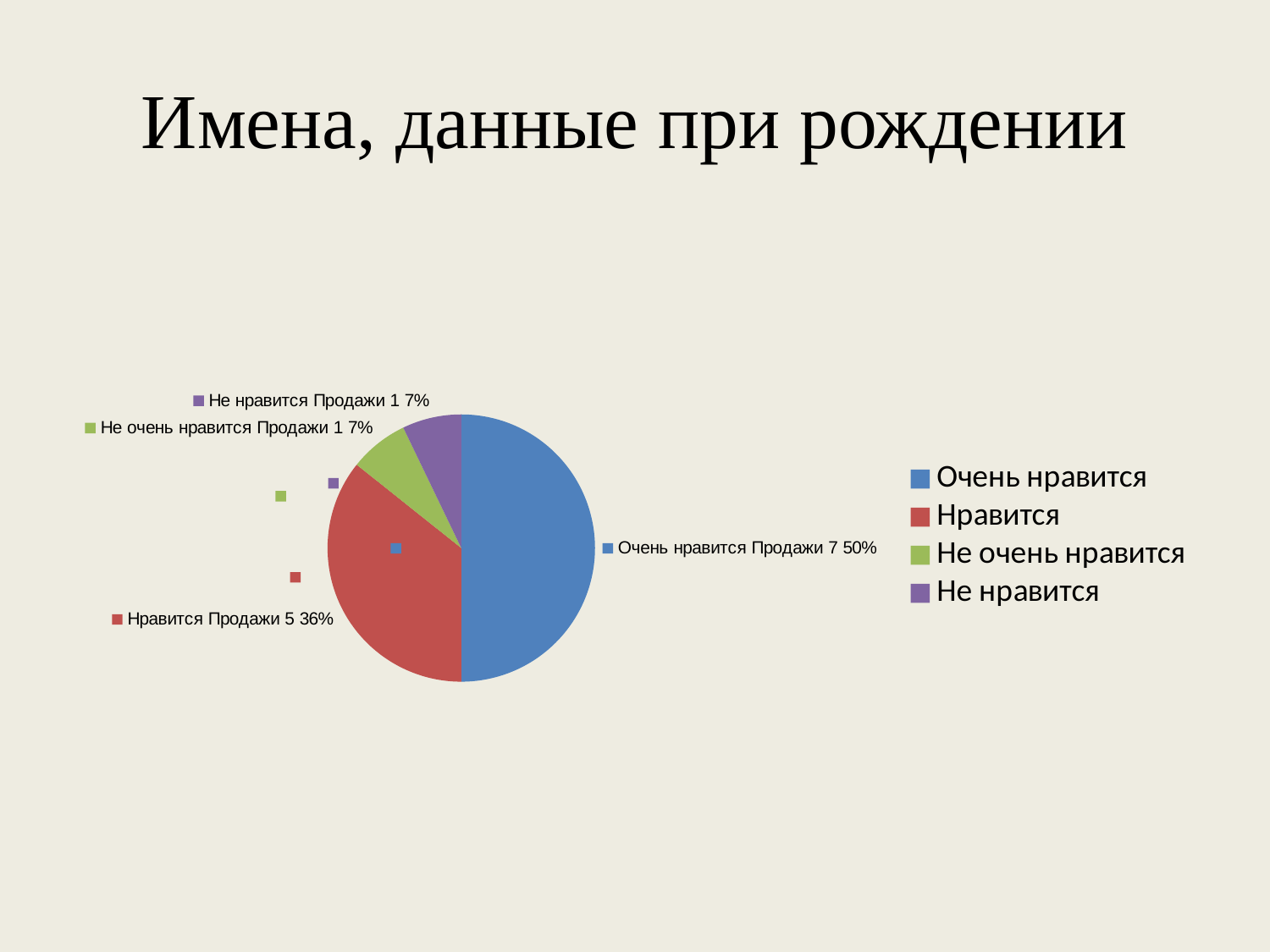
What kind of chart is shown on the slide? pie chart What is the value for "Очень нравится"? 7 What is the difference between the values for "Очень нравится" and "Нравится"? 2 What is the title of the slide containing the chart? Имена, данные при рождении How many categories does the legend list? 4 What is the value for "Не очень нравится"? 1 What is the value for "Нравится"? 5 Which is larger, the value for "Нравится" or the value for "Не очень нравится"? Нравится What percentage share does the "Не нравится" slice have? 7% Which category has the largest slice of the pie? Очень нравится What percentage share does the "Нравится" slice have? 36% What percentage share does the "Очень нравится" slice have? 50%